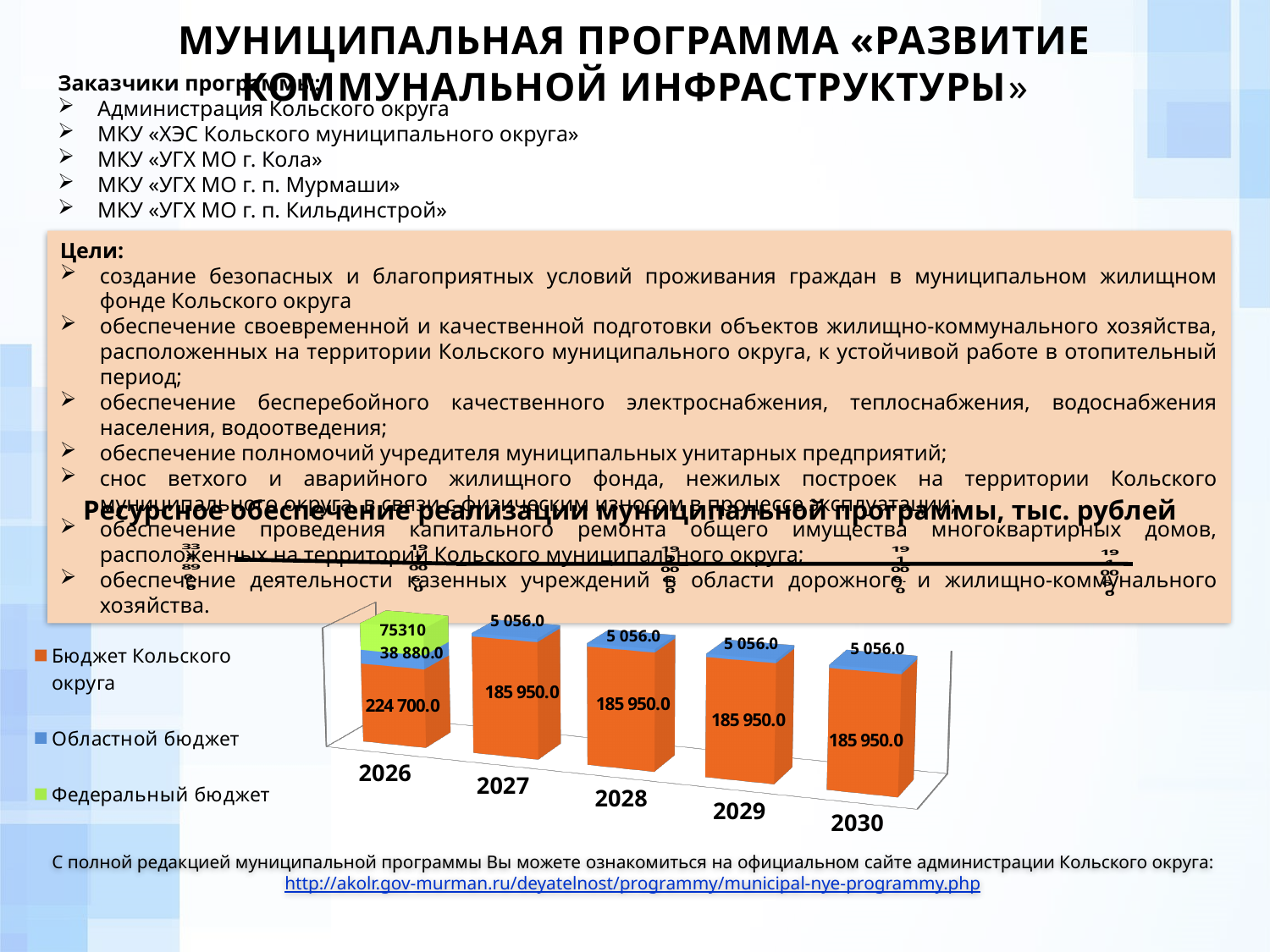
What type of chart is shown on the slide? stacked bar chart What is the value for Бюджет Кольского округа in 2026? 224 700.0 What is the difference between the Бюджет Кольского округа values for 2026 and 2027? 38 750.0 What is the value for Бюджет Кольского округа in 2028? 185 950.0 How many years are shown on the x axis of the chart? 5 Which year has the highest value for Бюджет Кольского округа? 2026 How many series does the chart legend list? 3 What is the value for Федеральный бюджет in 2026? 75310 What is the total of the stacked bar for 2027? 191 006.0 What is the value for Областной бюджет in 2026? 38 880.0 Which series is shown in orange in the chart? Бюджет Кольского округа What is the value for Областной бюджет in 2030? 5 056.0